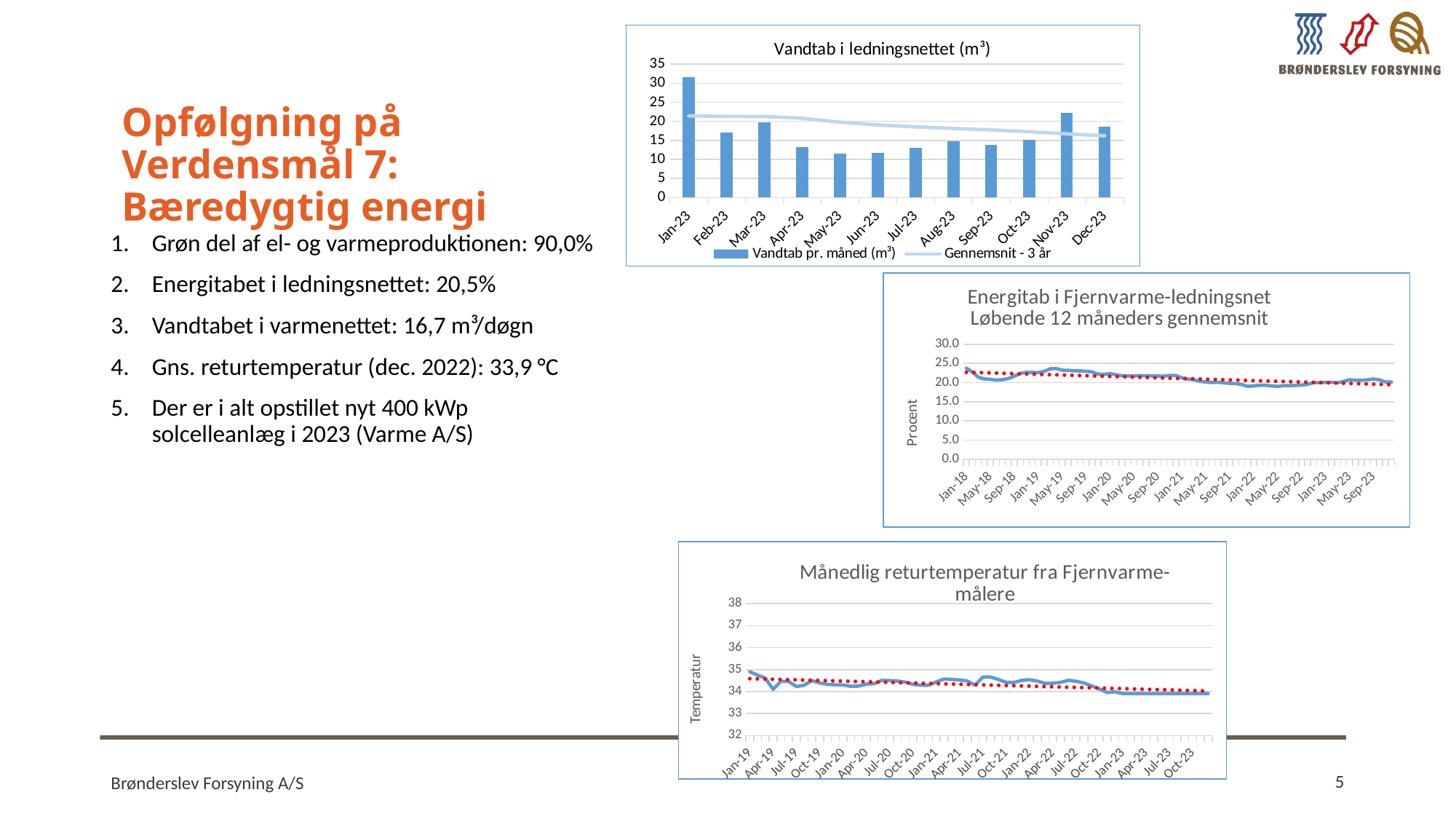
In the chart 'Energitab i Fjernvarme-ledningsnet Løbende 12 måneders gennemsnit', do the values generally rise or fall from Jan-18 to Sep-23? fall What kind of chart is 'Vandtab i ledningsnettet (m³)'? combination bar and line chart What kind of chart is 'Energitab i Fjernvarme-ledningsnet Løbende 12 måneders gennemsnit'? line chart How many series does the legend of 'Vandtab i ledningsnettet (m³)' list? 2 In the chart 'Vandtab i ledningsnettet (m³)', is the value for Jan-23 greater or less than 30? greater In the chart 'Vandtab i ledningsnettet (m³)', which is larger, the bar for Nov-23 or the bar for Dec-23? Nov-23 In the chart 'Vandtab i ledningsnettet (m³)', is the value for Apr-23 greater or less than 15? less What are the two legend entries in the chart 'Vandtab i ledningsnettet (m³)'? Vandtab pr. måned (m³) and Gennemsnit - 3 år In the chart 'Vandtab i ledningsnettet (m³)', which month has the highest bar? Jan-23 In the chart 'Vandtab i ledningsnettet (m³)', how many months are shown on the x axis? 12 In the chart 'Vandtab i ledningsnettet (m³)', is the value for Nov-23 greater or less than 20? greater